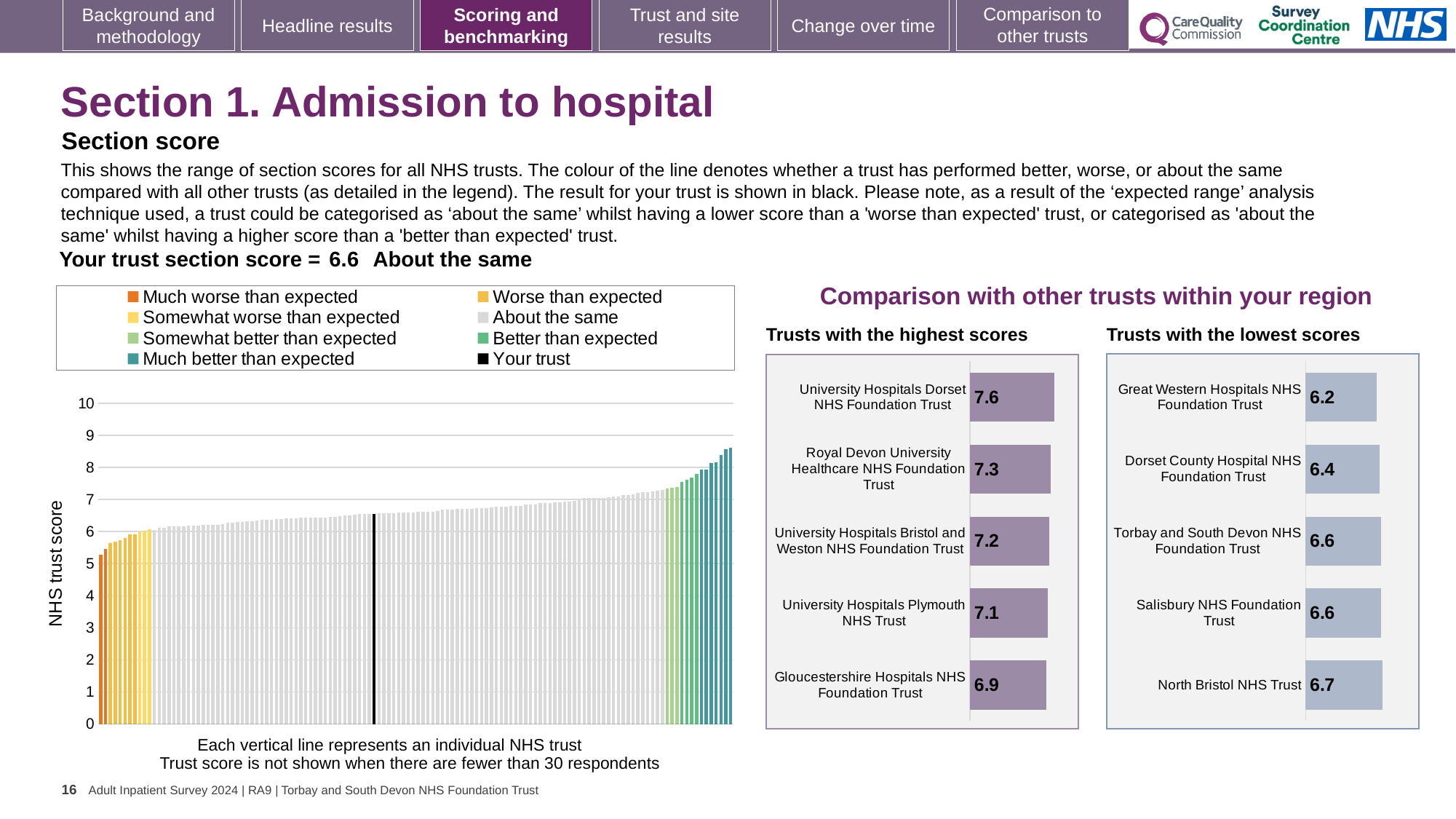
In the 'Trusts with the highest scores' chart, what is the difference between the scores of University Hospitals Dorset NHS Foundation Trust and Gloucestershire Hospitals NHS Foundation Trust? 0.7 In the 'Trusts with the highest scores' chart, which has the higher score: Royal Devon University Healthcare NHS Foundation Trust or University Hospitals Plymouth NHS Trust? Royal Devon University Healthcare NHS Foundation Trust In the 'Trusts with the lowest scores' chart, what is the difference between the scores of North Bristol NHS Trust and Great Western Hospitals NHS Foundation Trust? 0.5 How many trusts are shown in the 'Trusts with the highest scores' chart? 5 What kind of chart is the large 'NHS trust score' chart on the left of the slide? bar chart In the 'Trusts with the lowest scores' chart, what is the score for North Bristol NHS Trust? 6.7 In the 'Trusts with the lowest scores' chart, what is the score for Great Western Hospitals NHS Foundation Trust? 6.2 In the 'Trusts with the highest scores' chart, what is the score for University Hospitals Dorset NHS Foundation Trust? 7.6 In the 'Trusts with the highest scores' chart, which trust has the highest score? University Hospitals Dorset NHS Foundation Trust In the 'Trusts with the lowest scores' chart, which trust has the lowest score? Great Western Hospitals NHS Foundation Trust In the large 'NHS trust score' chart on the left, do the values rise or fall from left to right? rise How many entries does the legend above the large 'NHS trust score' chart list? 8